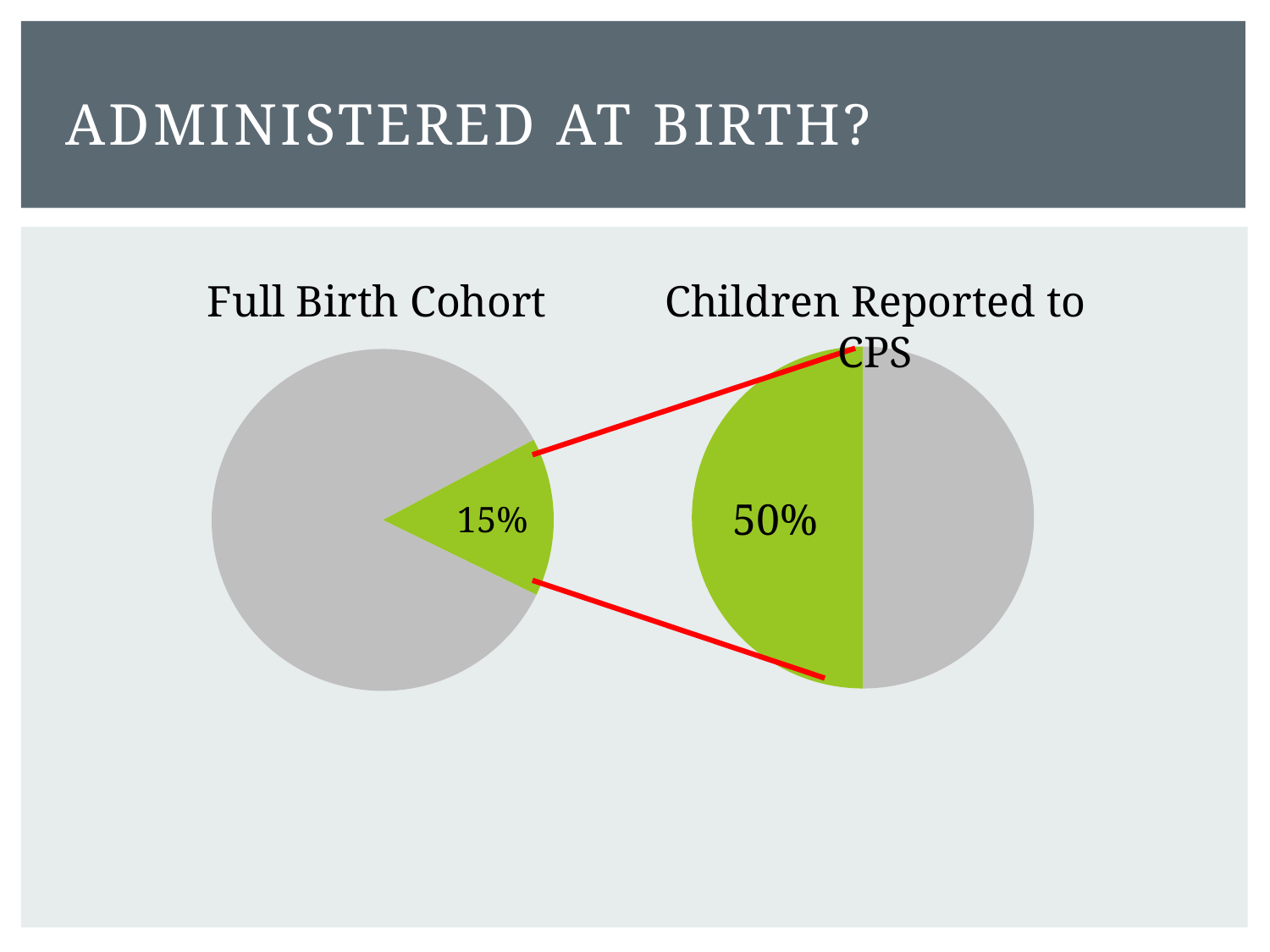
How many pie charts are shown on the slide? 2 In the 'Full Birth Cohort' pie chart, what share is shown for the green slice? 15% Which chart has the larger green slice, 'Full Birth Cohort' or 'Children Reported to CPS'? Children Reported to CPS How many slices does the 'Children Reported to CPS' pie chart have? 2 In the 'Children Reported to CPS' pie chart, what share is shown for the green slice? 50% What kind of chart is the 'Full Birth Cohort' chart? pie chart What is the difference between the green slice in 'Children Reported to CPS' (50%) and the green slice in 'Full Birth Cohort' (15%)? 35% What is the title of the pie chart on the left? Full Birth Cohort What is the title of the pie chart on the right? Children Reported to CPS In the 'Full Birth Cohort' pie chart, which slice is larger, the green slice or the grey slice? the grey slice